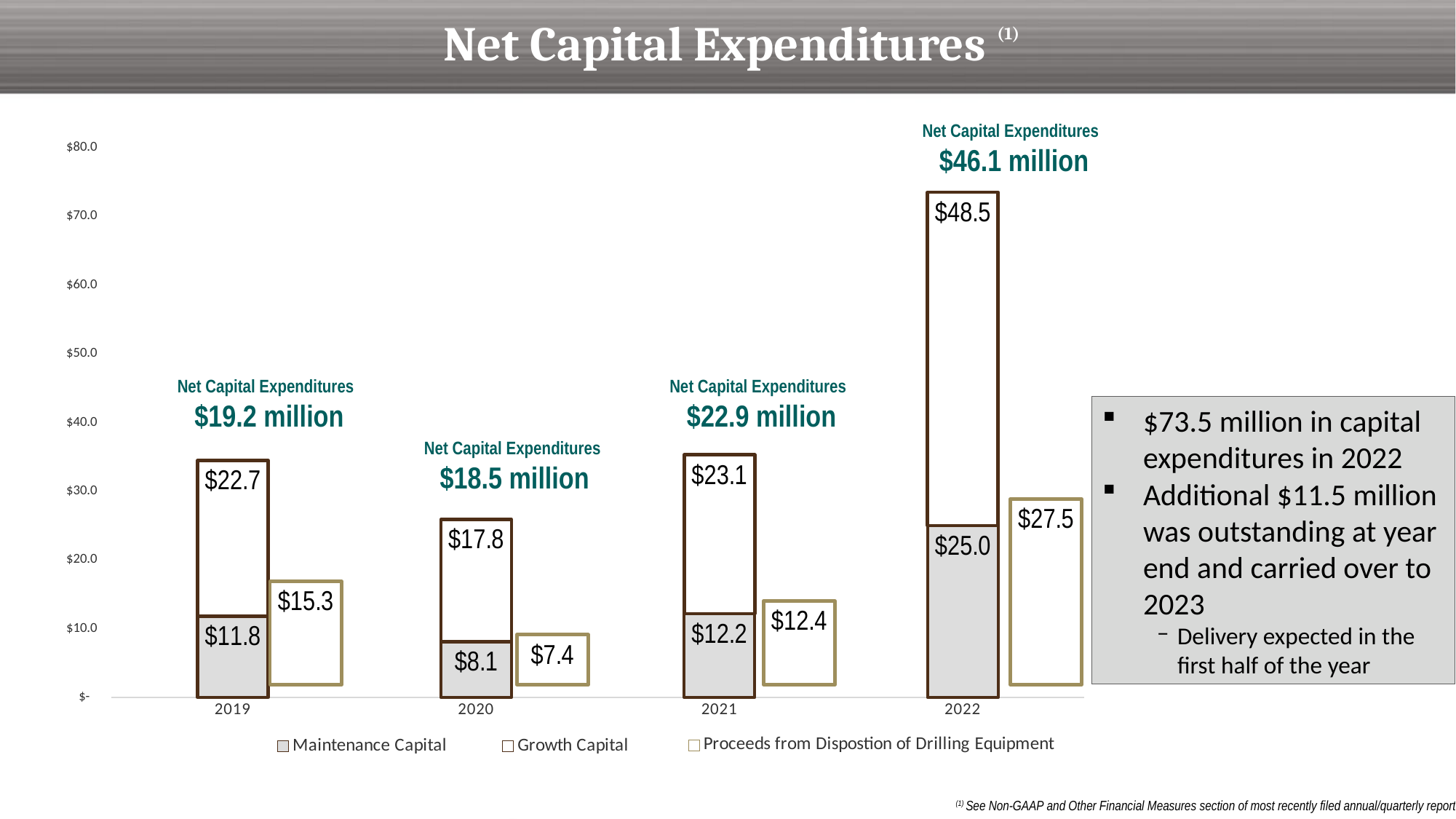
What are the Net Capital Expenditures shown for 2021? $22.9 million What is the Proceeds from Disposition of Drilling Equipment value for 2019? $15.3 What is the difference between the Growth Capital values for 2021 and 2020? $5.3 What is the Growth Capital value for 2020? $17.8 Which year has the highest Growth Capital value? 2022 What kind of chart is shown on the slide? Bar chart How many years are shown on the x axis? 4 Which is larger, the Proceeds from Disposition of Drilling Equipment in 2021 or the Maintenance Capital in 2021? Proceeds from Disposition of Drilling Equipment What is the total of the stacked Maintenance Capital and Growth Capital bar for 2022? $73.5 Which year has the lowest Maintenance Capital value? 2020 How many series does the legend list? 3 What is the Maintenance Capital value for 2022? $25.0